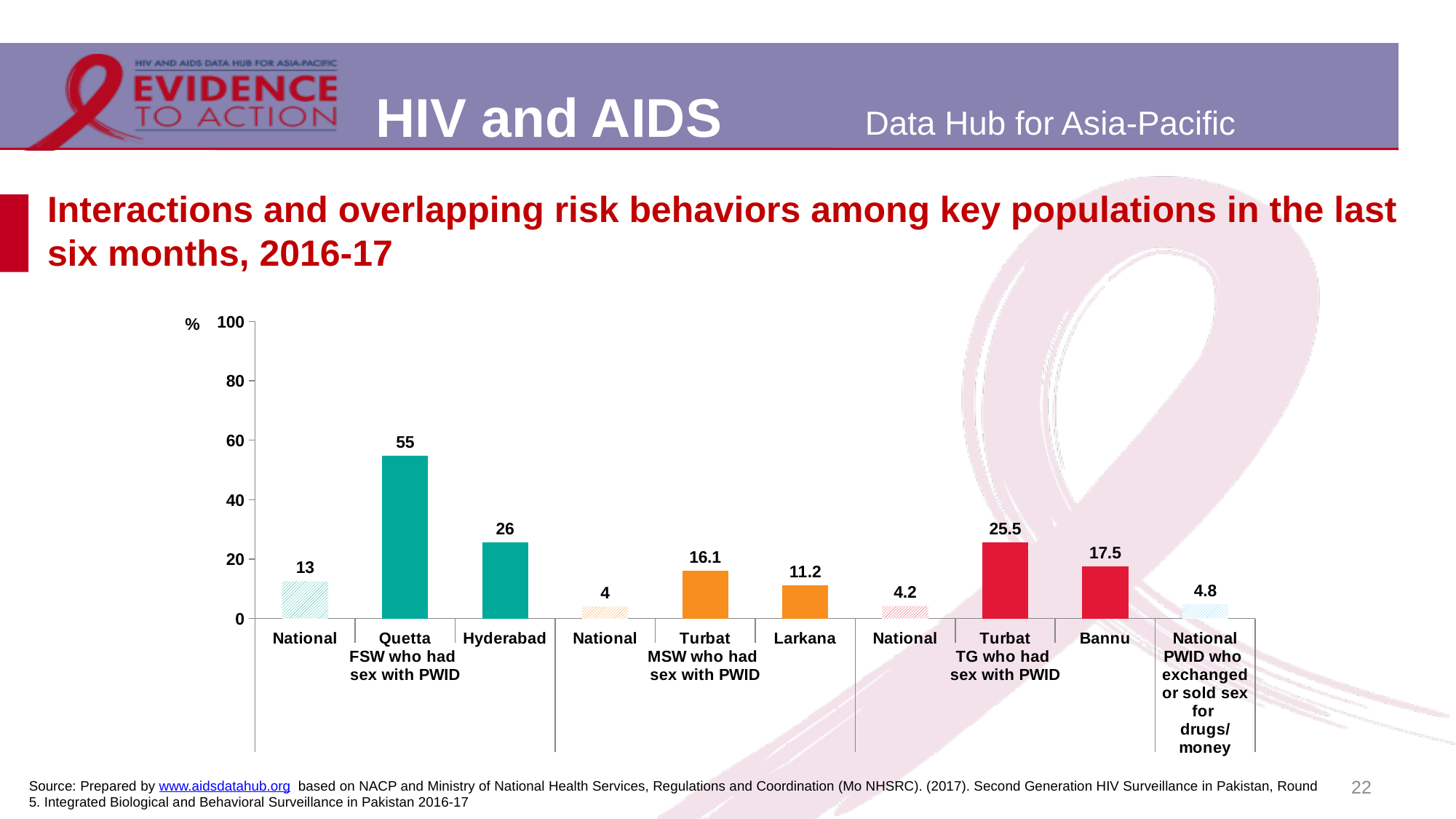
Which bar has the lowest value on the chart? National (MSW who had sex with PWID) What kind of chart is shown on the slide? Bar chart Is the value for Larkana greater or less than 20? less What is the difference between the national values for FSW who had sex with PWID and TG who had sex with PWID? 8.8 What is the value for Quetta in the FSW who had sex with PWID group? 55 What is the value for national PWID who exchanged or sold sex for drugs/money? 4.8 Which bar has the highest value on the chart? Quetta (FSW who had sex with PWID) What is the value for Bannu in the TG who had sex with PWID group? 17.5 Which is larger: the Turbat value for MSW who had sex with PWID or the Turbat value for TG who had sex with PWID? Turbat value for TG who had sex with PWID What is the difference between the Quetta and Hyderabad values for FSW who had sex with PWID? 29 What is the national value for MSW who had sex with PWID? 4 How many bars are plotted on the chart? 10